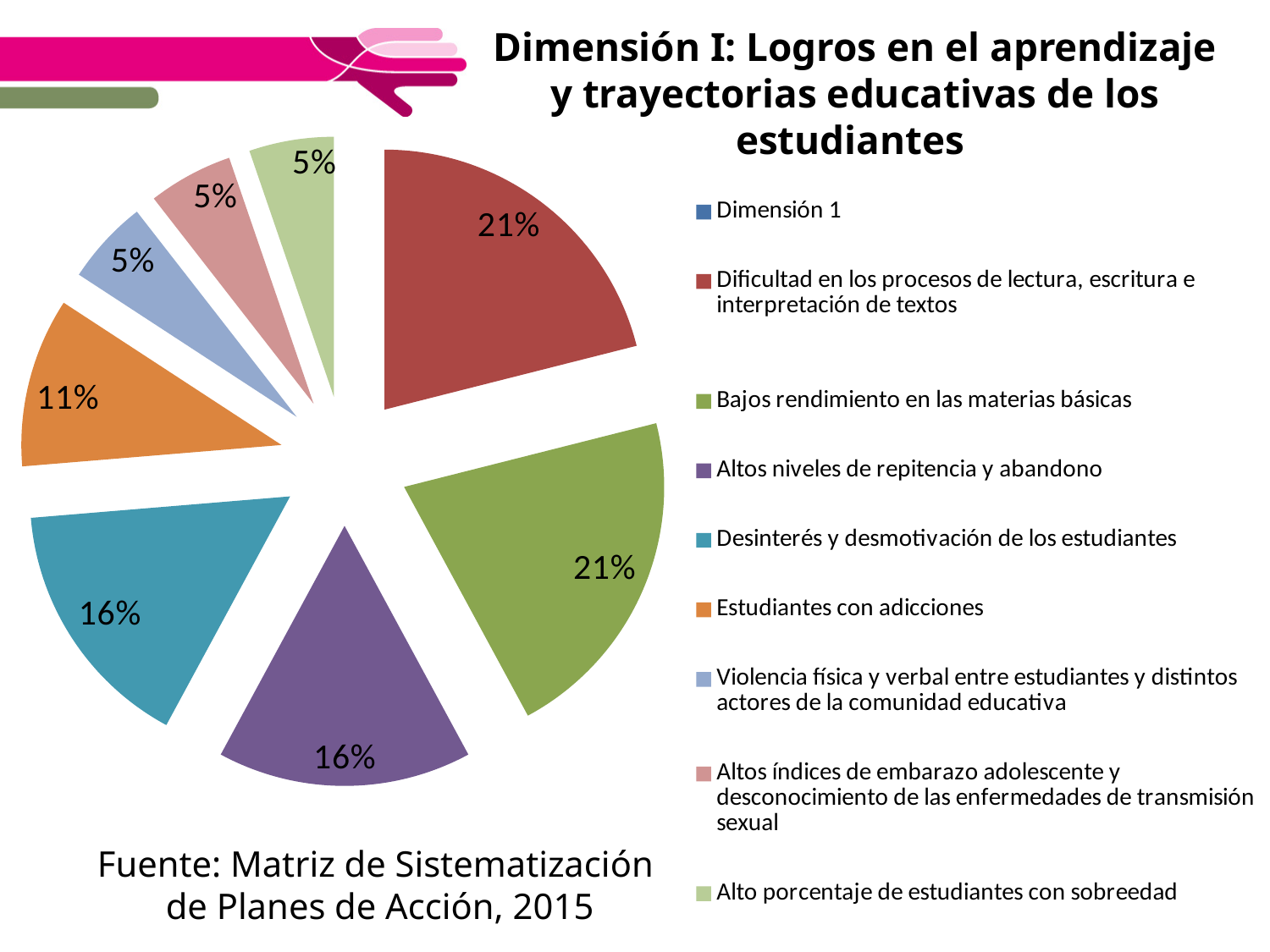
Which is larger, the slice for "Estudiantes con adicciones" or the slice for "Desinterés y desmotivación de los estudiantes"? Desinterés y desmotivación de los estudiantes What is the value shown for "Desinterés y desmotivación de los estudiantes"? 16% What share of the pie does "Bajos rendimiento en las materias básicas" represent? 21% What share of the pie does "Dificultad en los procesos de lectura, escritura e interpretación de textos" represent? 21% How many entries does the legend list? 9 What is the value shown for "Altos niveles de repitencia y abandono"? 16% What kind of chart is shown on the slide? Pie chart What share of the pie does "Alto porcentaje de estudiantes con sobreedad" represent? 5% What is the title of the chart? Dimensión I: Logros en el aprendizaje y trayectorias educativas de los estudiantes What is the value shown for "Estudiantes con adicciones"? 11% What is the difference in percentage points between "Bajos rendimiento en las materias básicas" and "Estudiantes con adicciones"? 10 percentage points What is the value shown for "Violencia física y verbal entre estudiantes y distintos actores de la comunidad educativa"? 5%